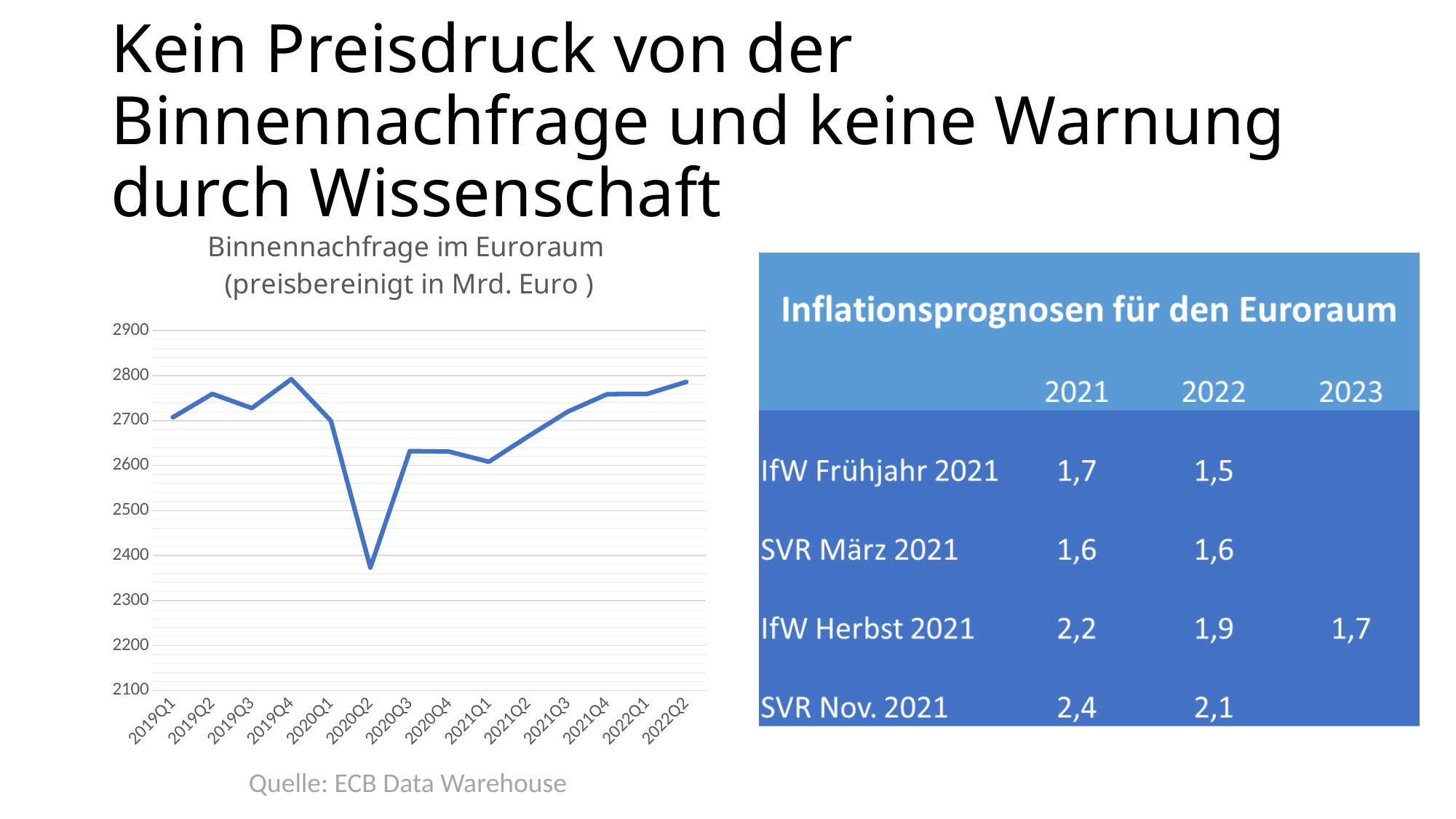
Is the value for 2021Q4 in the line chart greater or less than 2700? greater What source is given below the line chart? ECB Data Warehouse Which quarter has the lowest value in the line chart? 2020Q2 Is the value for 2020Q2 in the line chart greater or less than 2400? less What is the title of the line chart? Binnennachfrage im Euroraum (preisbereinigt in Mrd. Euro ) What kind of chart is shown on the left of the slide? line chart Does the line chart rise or fall from 2020Q2 to 2022Q2? rise In the line chart, which is larger, the value for 2019Q4 or the value for 2020Q1? 2019Q4 In the line chart, which is larger, the value for 2020Q2 or the value for 2020Q3? 2020Q3 Is the value for 2020Q1 in the line chart greater or less than 2800? less How many quarters are plotted on the x axis of the line chart? 14